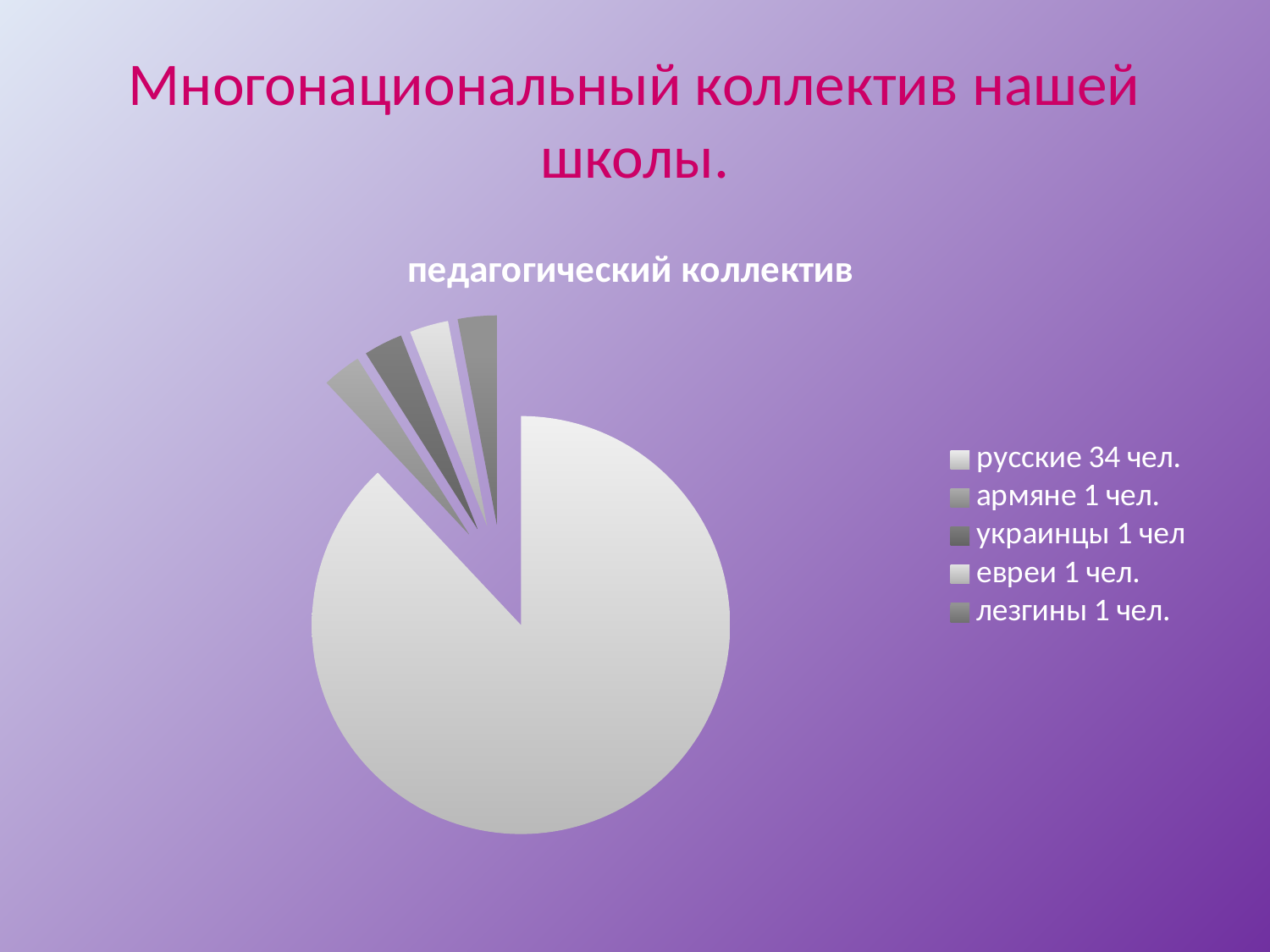
Which is larger, the value for русские or the value for евреи? русские What is the title of the chart? педагогический коллектив How many people are listed for русские in the legend? 34 чел. How many people are listed for лезгины in the legend? 1 чел. Which category has the largest slice of the pie? русские How many people are listed for армяне in the legend? 1 чел. How many categories does the pie chart have? 5 What is the difference between the number of русские and the number of украинцы? 33 Which category is listed second in the legend? армяне 1 чел. Is the value for русские greater or less than 30? greater What kind of chart is shown on the slide? pie chart